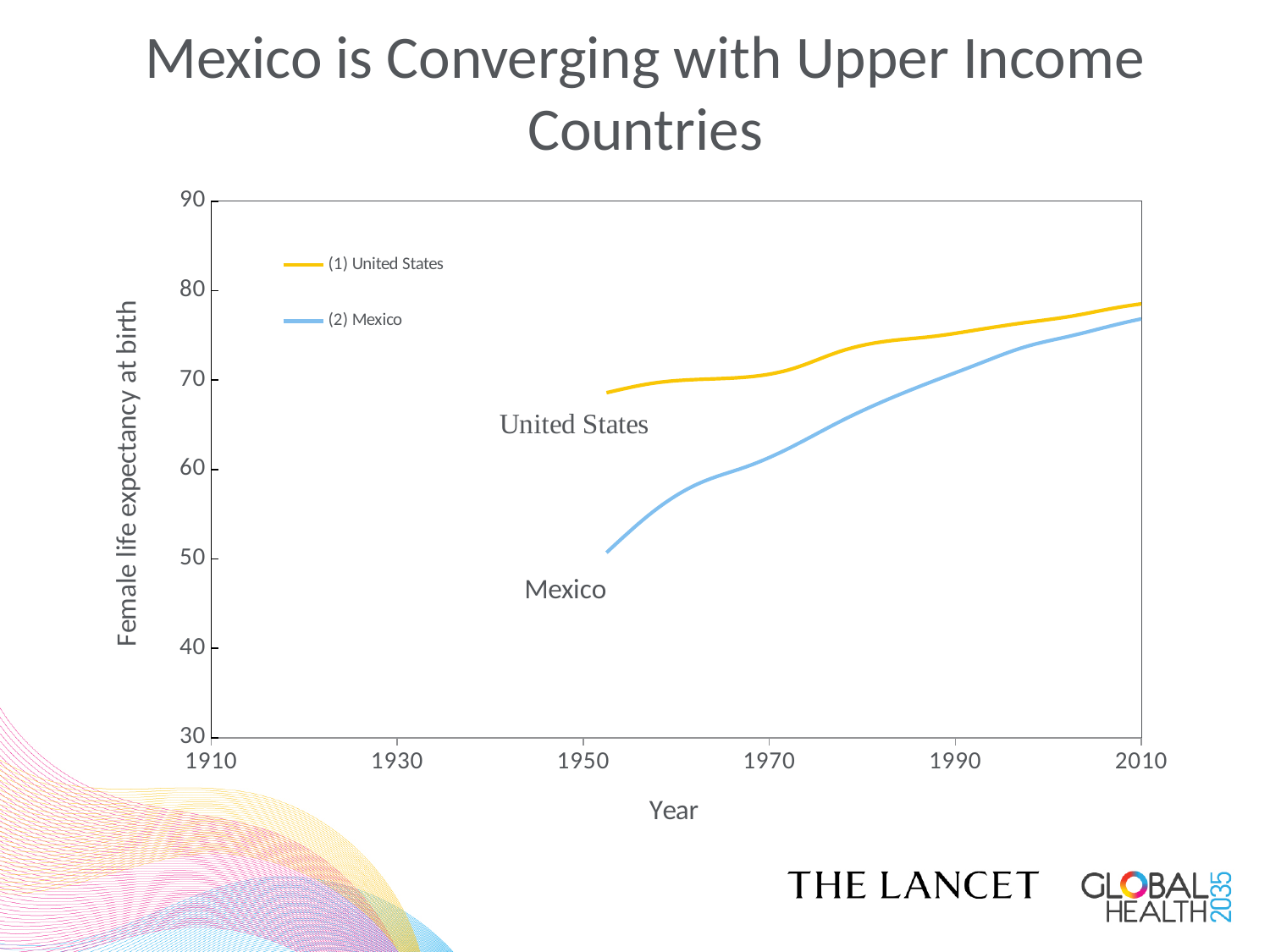
Is the value for the United States in 1990 greater or less than 70? greater In 1970, which series has the higher female life expectancy, United States or Mexico? United States Is the value for Mexico in 2010 greater or less than 70? greater What kind of chart is shown on the slide? Line chart Which two series are plotted in the chart? United States and Mexico Is the value for Mexico in 1960 greater or less than 60? less How many series does the legend list? 2 Does female life expectancy for Mexico rise or fall from 1950 to 2010? Rise Does female life expectancy for the United States rise or fall from 1950 to 2010? Rise What is the label of the y axis? Female life expectancy at birth